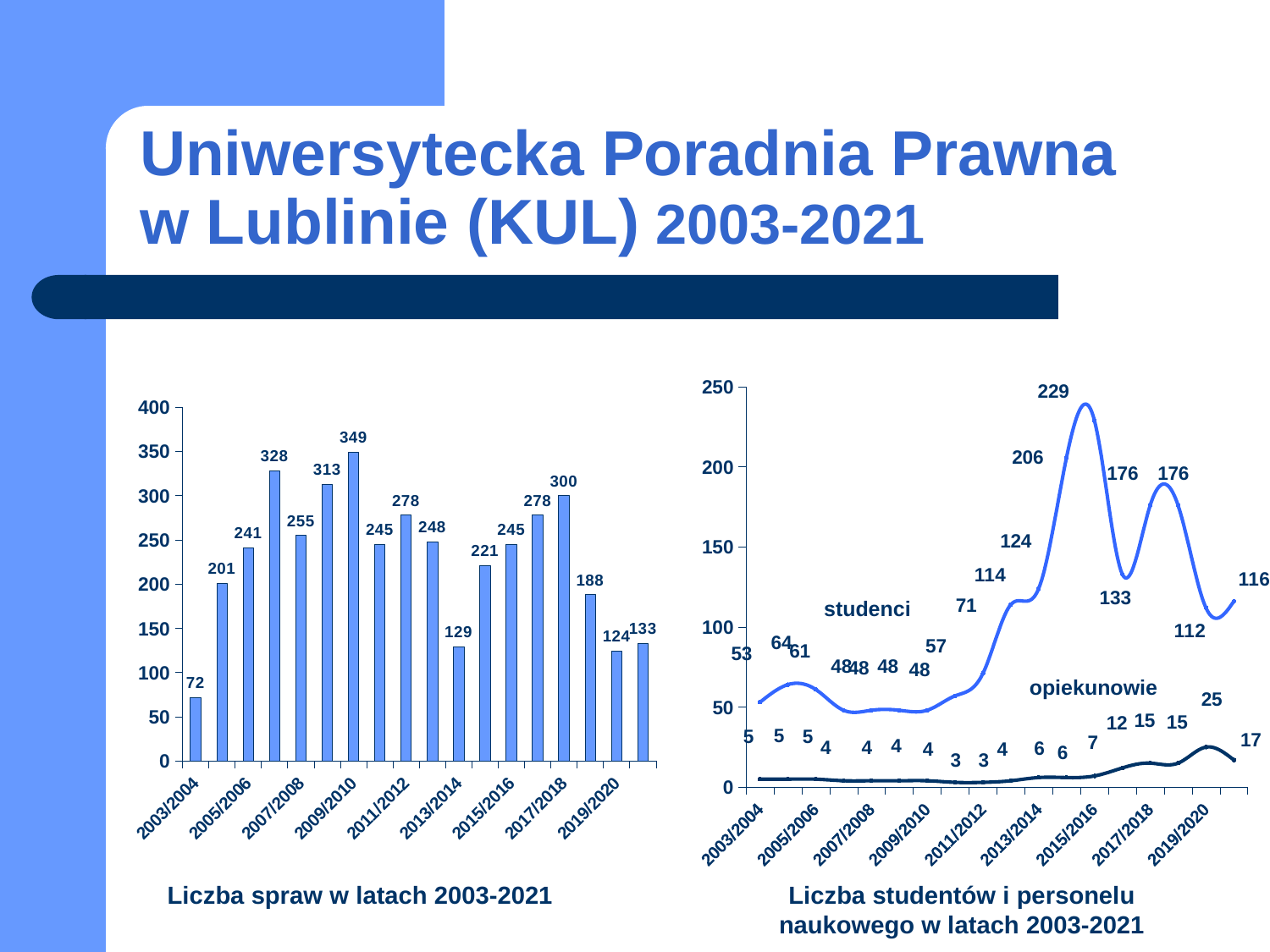
What kind of chart is the left chart, 'Liczba spraw w latach 2003-2021'? bar chart In the right chart 'Liczba studentów i personelu naukowego w latach 2003-2021', what is the value of 'opiekunowie' for 2019/2020? 25 In the left chart 'Liczba spraw w latach 2003-2021', which year has the lowest value? 2003/2004 In the left chart 'Liczba spraw w latach 2003-2021', which year has the highest value? 2009/2010 How many bars are plotted in the left chart 'Liczba spraw w latach 2003-2021'? 18 In the left chart 'Liczba spraw w latach 2003-2021', what is the value for 2013/2014? 129 In the left chart 'Liczba spraw w latach 2003-2021', what is the value for 2009/2010? 349 What are the names of the two series shown in the right chart 'Liczba studentów i personelu naukowego w latach 2003-2021'? studenci and opiekunowie How many series are plotted in the right chart 'Liczba studentów i personelu naukowego w latach 2003-2021'? 2 In the right chart 'Liczba studentów i personelu naukowego w latach 2003-2021', what is the highest value of the 'studenci' series? 229 What kind of chart is the right chart, 'Liczba studentów i personelu naukowego w latach 2003-2021'? line chart In the left chart 'Liczba spraw w latach 2003-2021', what is the difference between the highest value (349) and the lowest value (72)? 277